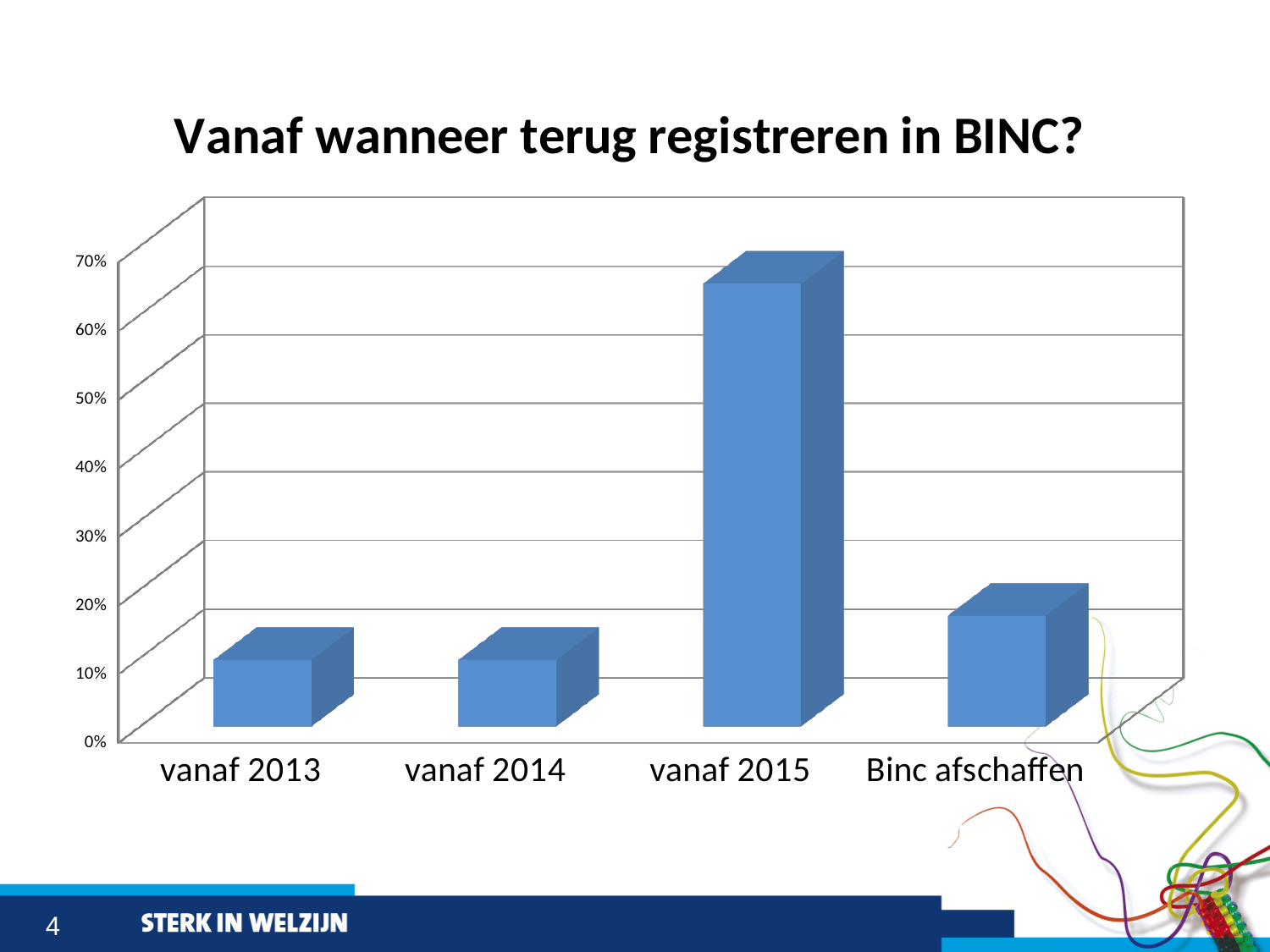
Is the value for vanaf 2015 greater or less than 50%? greater Which is larger, the value for vanaf 2015 or the value for Binc afschaffen? vanaf 2015 What kind of chart is shown on the slide? bar chart Is the value for Binc afschaffen greater or less than 30%? less Is the value for Binc afschaffen greater or less than 10%? greater Which category has the highest value? vanaf 2015 How many categories are shown on the x axis of the chart? 4 Which is larger, the value for Binc afschaffen or the value for vanaf 2013? Binc afschaffen What is the title of the chart? Vanaf wanneer terug registreren in BINC? What is the highest value labelled on the vertical axis? 70%